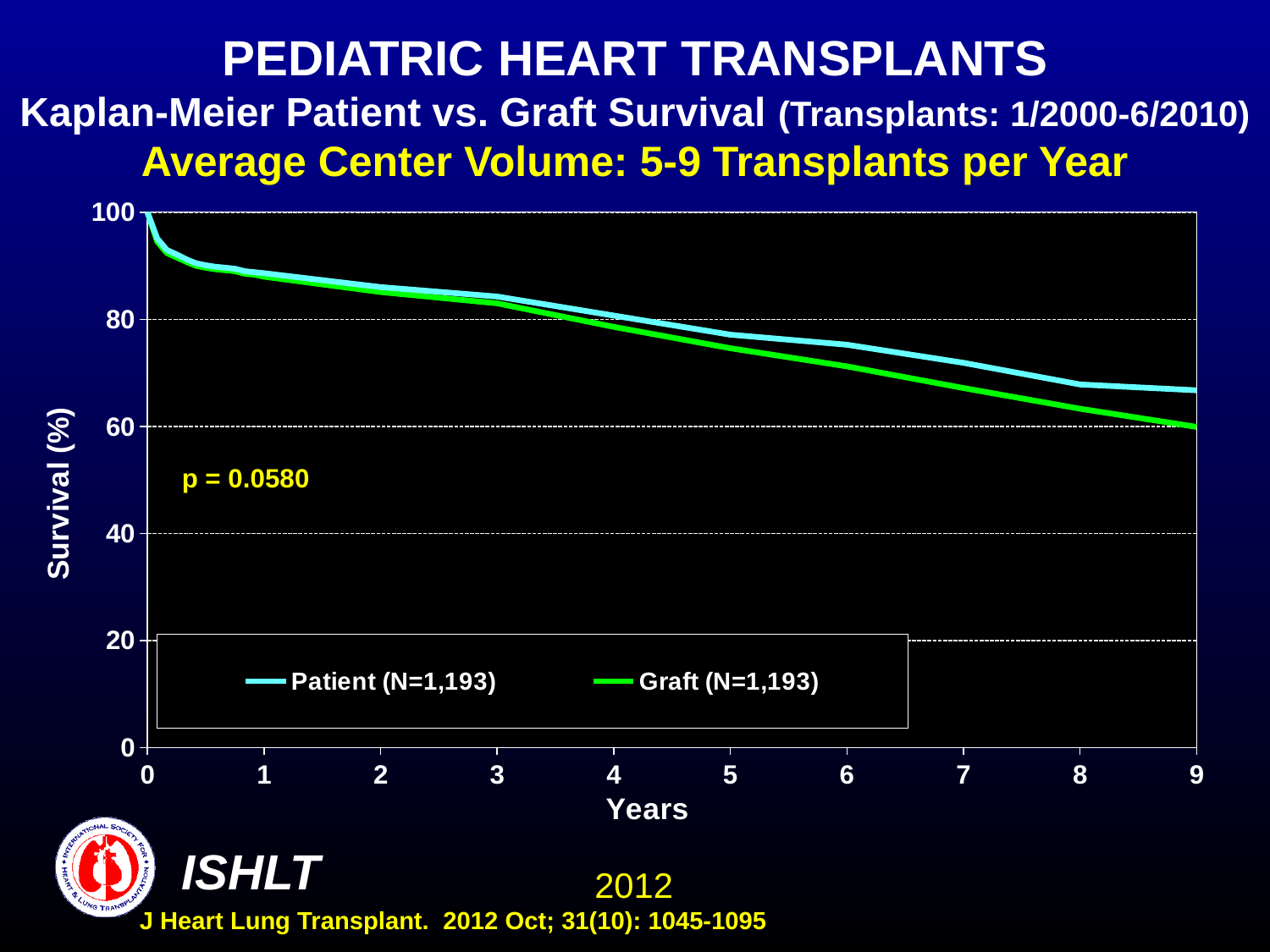
Is the Patient survival at 1 year greater or less than 80? greater Do the survival curves rise or fall as the years increase? Fall At 8 years, which curve shows higher survival, Patient or Graft? Patient What is the p-value shown on the chart? p = 0.0580 What is the N for the Graft series in the legend? N=1,193 What is the label of the y axis? Survival (%) Is the Graft survival at 5 years greater or less than 80? less What kind of chart is shown on the slide? Line chart How many series does the legend list? 2 What is the maximum value shown on the x axis (Years)? 9 Is the Patient survival at 9 years greater or less than 60? greater